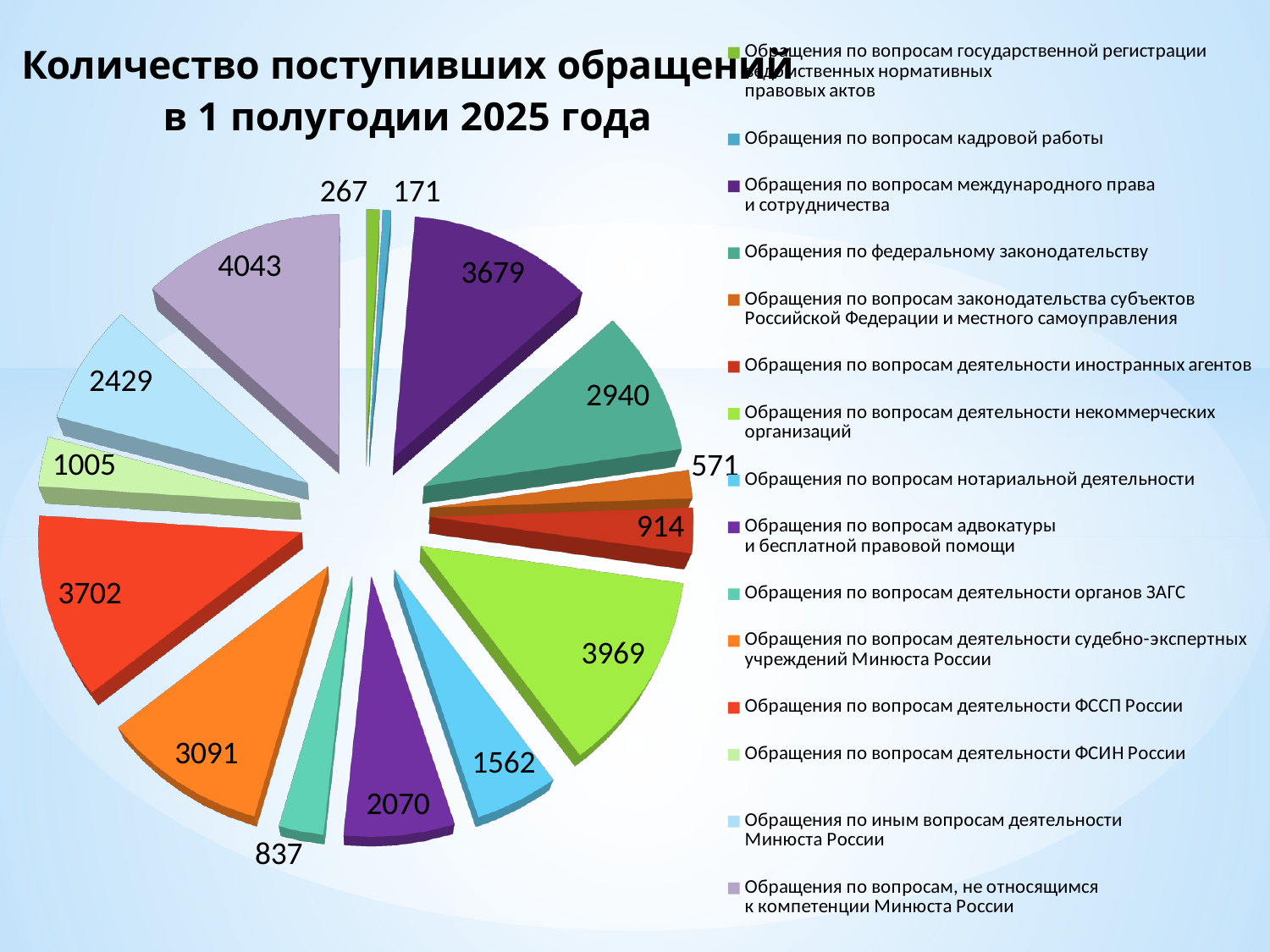
What is the value for "Обращения по вопросам деятельности ФССП России"? 3702 What is the value for "Обращения по вопросам нотариальной деятельности"? 1562 What is the value for "Обращения по вопросам деятельности органов ЗАГС"? 837 What is the title of the chart? Количество поступивших обращений в 1 полугодии 2025 года How many categories does the pie chart contain? 15 Which category has the smallest value? Обращения по вопросам кадровой работы What is the difference between the values for "Обращения по вопросам деятельности некоммерческих организаций" and "Обращения по вопросам деятельности ФСИН России"? 2964 Which category has the largest value? Обращения по вопросам, не относящимся к компетенции Минюста России What is the value for "Обращения по вопросам международного права и сотрудничества"? 3679 What is the difference between the values for "Обращения по вопросам деятельности иностранных агентов" and "Обращения по вопросам законодательства субъектов Российской Федерации и местного самоуправления"? 343 What kind of chart is shown on the slide? Pie chart Which is larger: the value for "Обращения по вопросам деятельности судебно-экспертных учреждений Минюста России" or the value for "Обращения по федеральному законодательству"? Обращения по вопросам деятельности судебно-экспертных учреждений Минюста России